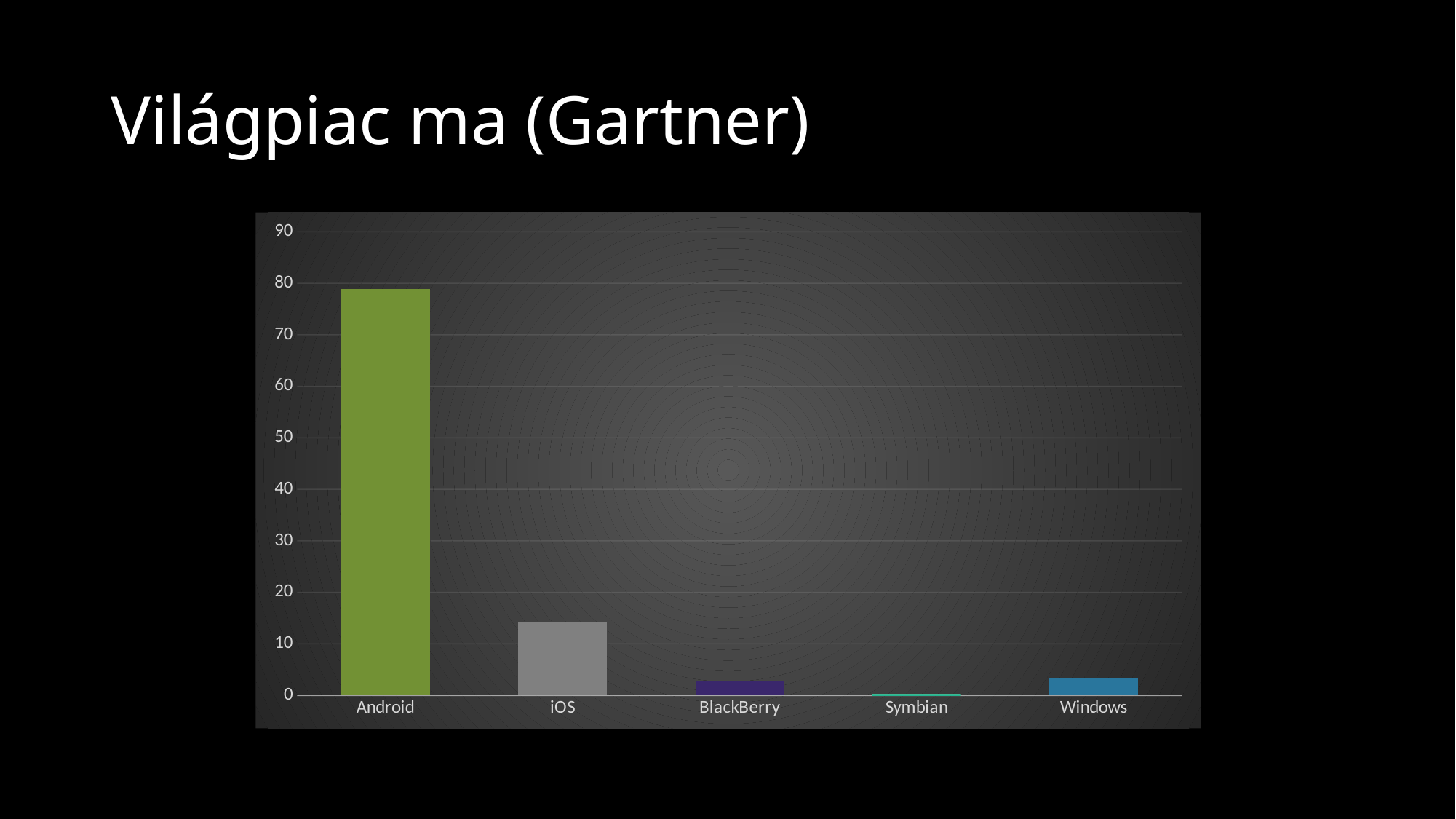
Which category has the highest bar in the chart? Android Is the value for iOS greater or less than 20? less Is the value for Windows greater or less than 10? less Which category has the lowest bar in the chart? Symbian Is the value for Android greater or less than 70? greater Which is larger, the value for Android or the value for iOS? Android Which is larger, the value for iOS or the value for Windows? iOS How many categories are shown on the x axis of the chart? 5 What colour is the bar for Android? green What kind of chart is shown on the slide? bar chart